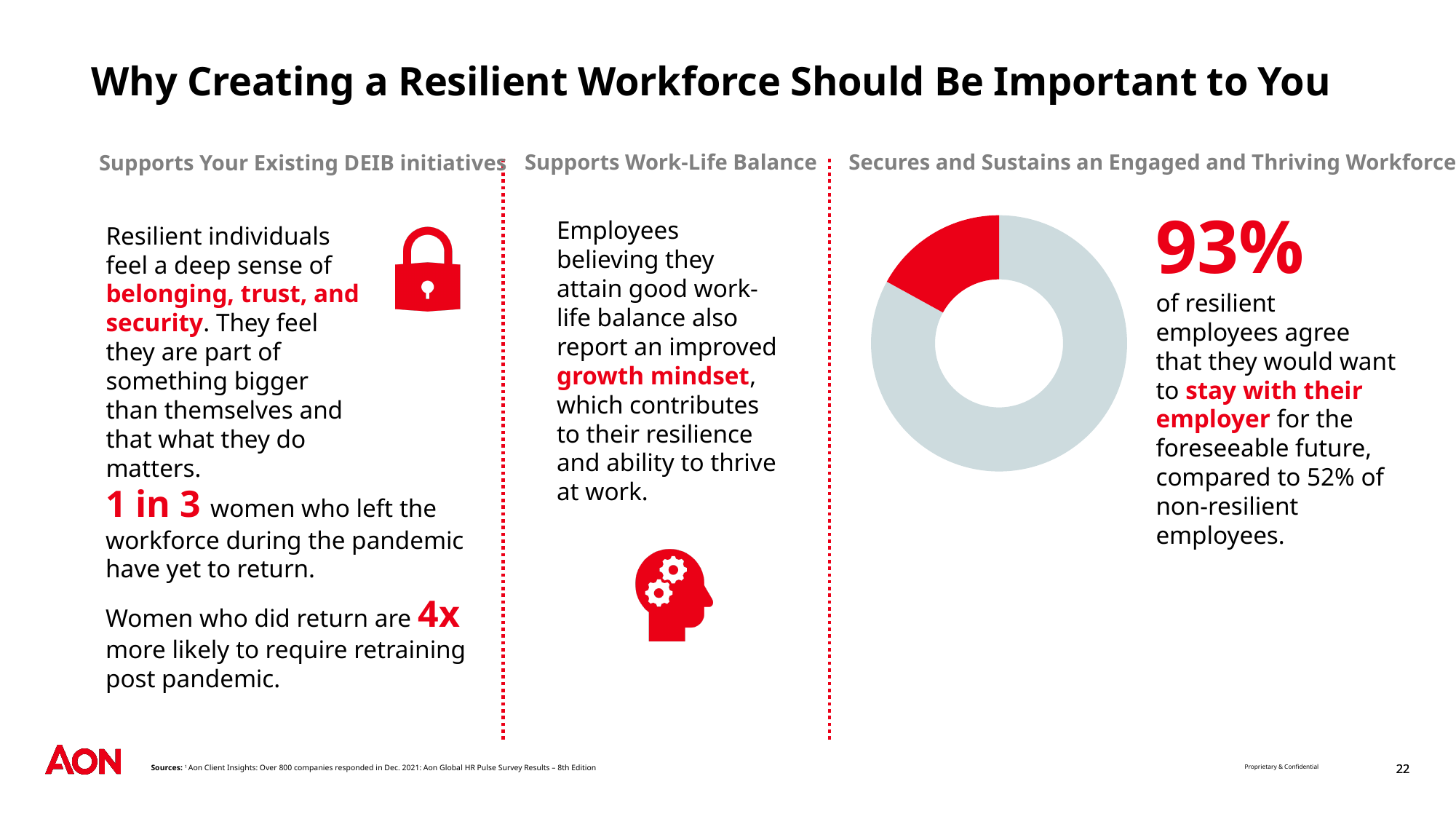
Is the red slice of the donut chart greater or less than 50% of the chart? less Which slice of the donut chart is larger, the red one or the grey one? the grey one What kind of chart is shown on the slide? donut chart Which slice of the donut chart is the smallest? the red slice What two colours are used for the slices of the donut chart? red and grey How many slices does the donut chart have? 2 Under which column heading does the donut chart appear? Secures and Sustains an Engaged and Thriving Workforce